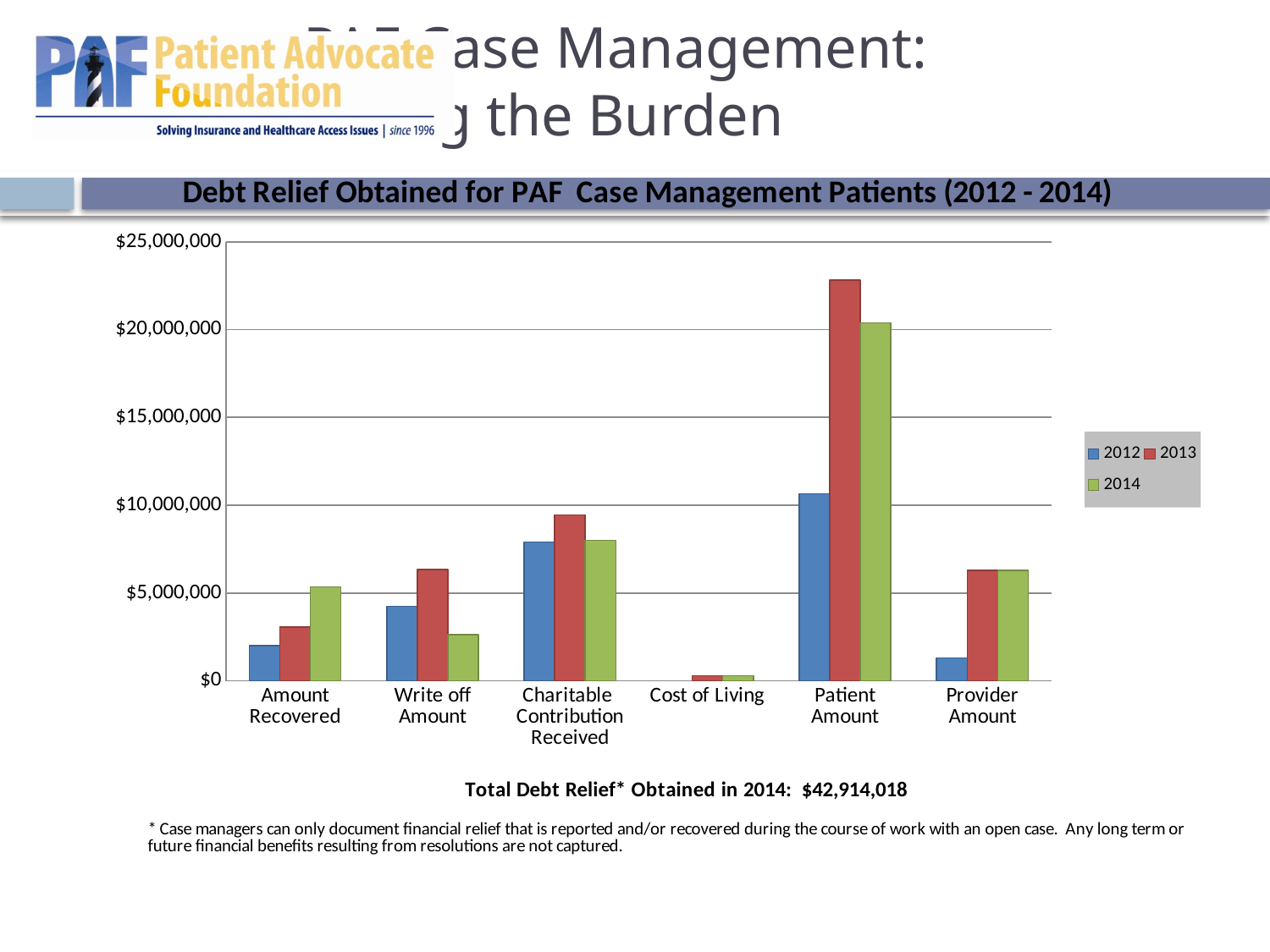
Is the 2013 value for Patient Amount greater or less than $20,000,000? greater For Write off Amount, which year has the larger value, 2013 or 2014? 2013 Which category has the lowest value for 2013? Cost of Living Is the 2012 value for Patient Amount greater or less than $15,000,000? less What kind of chart is shown on the slide? Bar chart How many series does the legend list? 3 Do the values for Amount Recovered rise or fall from 2012 to 2014? rise What is the title of the chart? Debt Relief Obtained for PAF Case Management Patients (2012 - 2014) How many categories are shown on the x axis? 6 Which category has the highest value for 2013? Patient Amount Is the 2013 value for Charitable Contribution Received greater or less than $10,000,000? less For Amount Recovered, which year has the larger value, 2012 or 2014? 2014